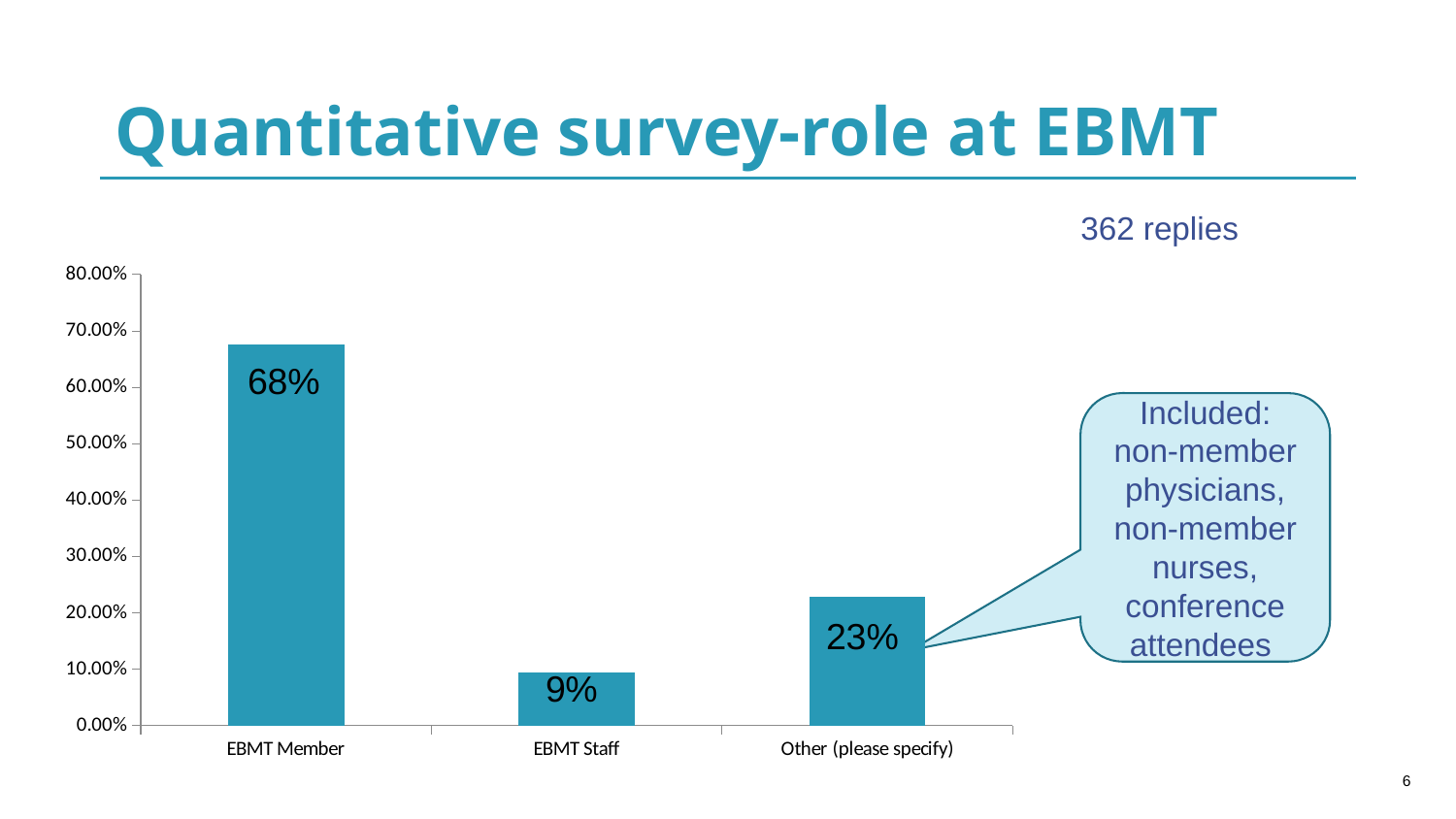
What is the value for Other (please specify)? 23% Which category has the highest value? EBMT Member What is the difference between the values for Other (please specify) and EBMT Staff? 14% What is the value for EBMT Member? 68% What is the value for EBMT Staff? 9% What kind of chart is shown on the slide? bar chart Is the value for EBMT Member greater or less than 60.00%? greater Which is larger, the value for EBMT Staff or the value for Other (please specify)? Other (please specify) How many replies does the slide say the survey received? 362 replies What is the difference between the values for EBMT Member and Other (please specify)? 45% Which category has the lowest value? EBMT Staff How many categories are shown on the x axis? 3